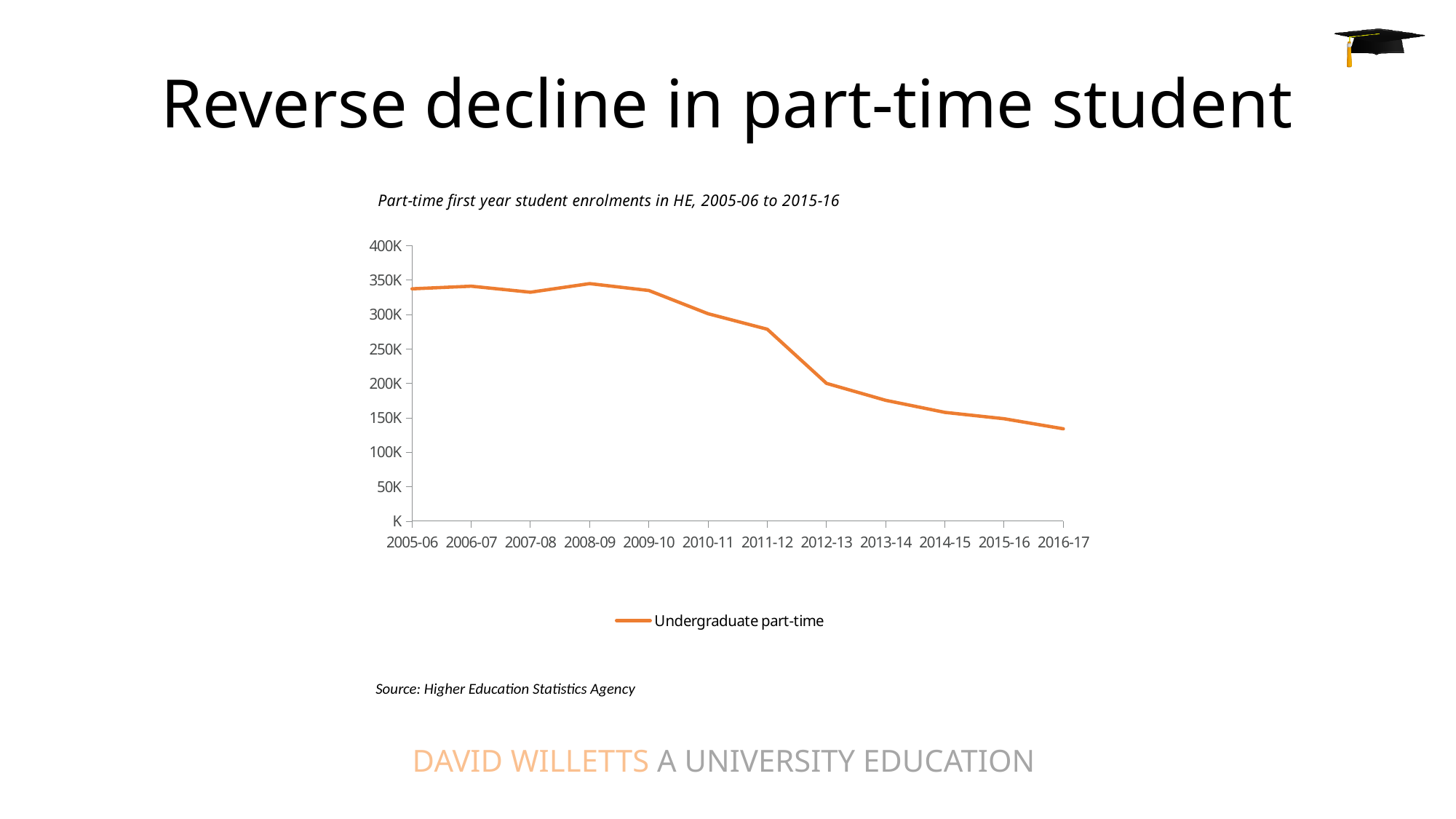
Is the value for 2011-12 greater or less than 250K? greater What is the title of the chart? Part-time first year student enrolments in HE, 2005-06 to 2015-16 Which academic year has the lowest value for Undergraduate part-time? 2016-17 How many series does the legend list? 1 Is the value for 2005-06 greater or less than 300K? greater Is the value for 2016-17 greater or less than 150K? less What is the source cited below the chart? Higher Education Statistics Agency What kind of chart is shown on the slide? line chart How many academic years are plotted on the x axis? 12 Which is larger, the value for 2011-12 or the value for 2012-13? 2011-12 Do the values for Undergraduate part-time generally rise or fall from 2005-06 to 2016-17? fall